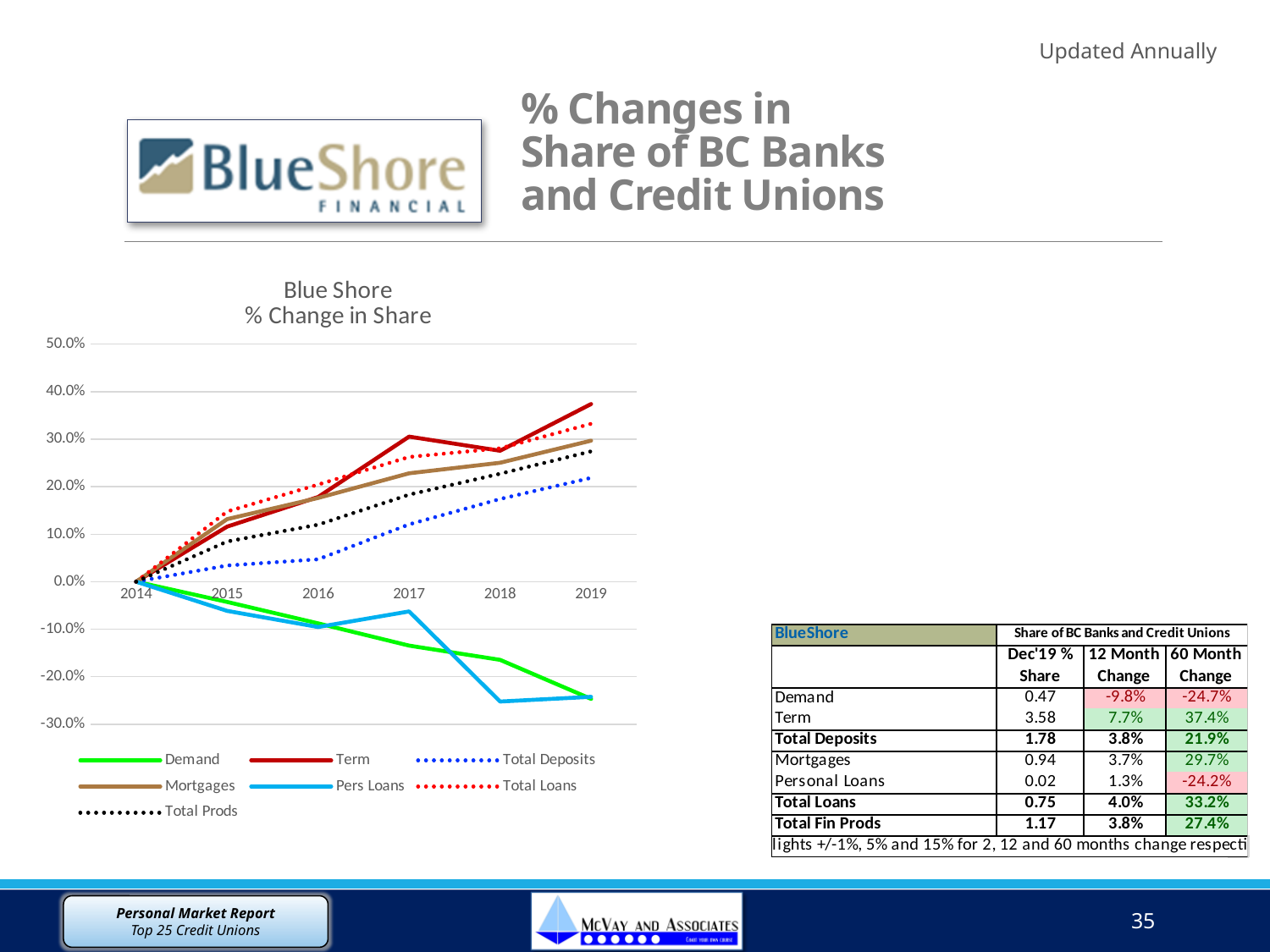
Is the value for Demand in 2019 greater or less than -20.0%? less How many series does the legend of the chart list? 7 In 2017, which is larger: Pers Loans or Demand? Pers Loans Is the value for Total Deposits in 2016 greater or less than 10.0%? less Is the value for Term in 2019 greater or less than 30.0%? greater What kind of chart is shown on the slide? line chart Which series has the highest value in 2019? Term What is the value for Term in 2014? 0.0% Does the Demand series rise or fall from 2014 to 2019? fall How many years are shown along the x axis of the chart? 6 In 2019, which is larger: Term or Mortgages? Term Which series has the lowest value in 2018? Pers Loans